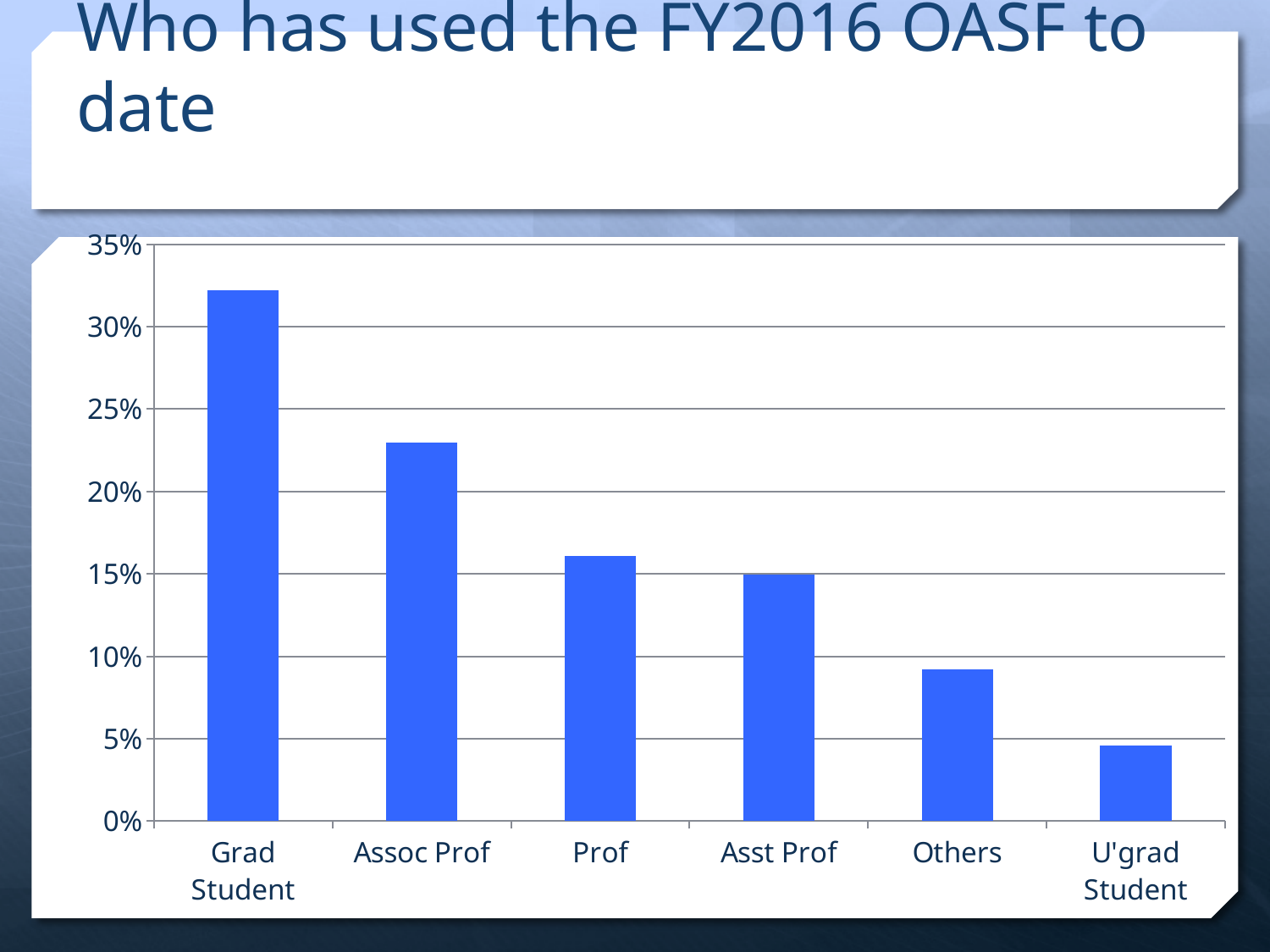
How many categories are shown on the x axis of the chart? 6 Is the value for Assoc Prof greater or less than 20%? greater What is the title of the slide containing the chart? Who has used the FY2016 OASF to date Is the value for Grad Student greater or less than 30%? greater Do the values rise or fall moving from left to right along the x axis? fall Is the value for U'grad Student greater or less than 5%? less Which is larger, the value for Assoc Prof or the value for Prof? Assoc Prof What kind of chart is shown on the slide? bar chart Which category has the lowest value in the chart? U'grad Student Which category has the highest value in the chart? Grad Student